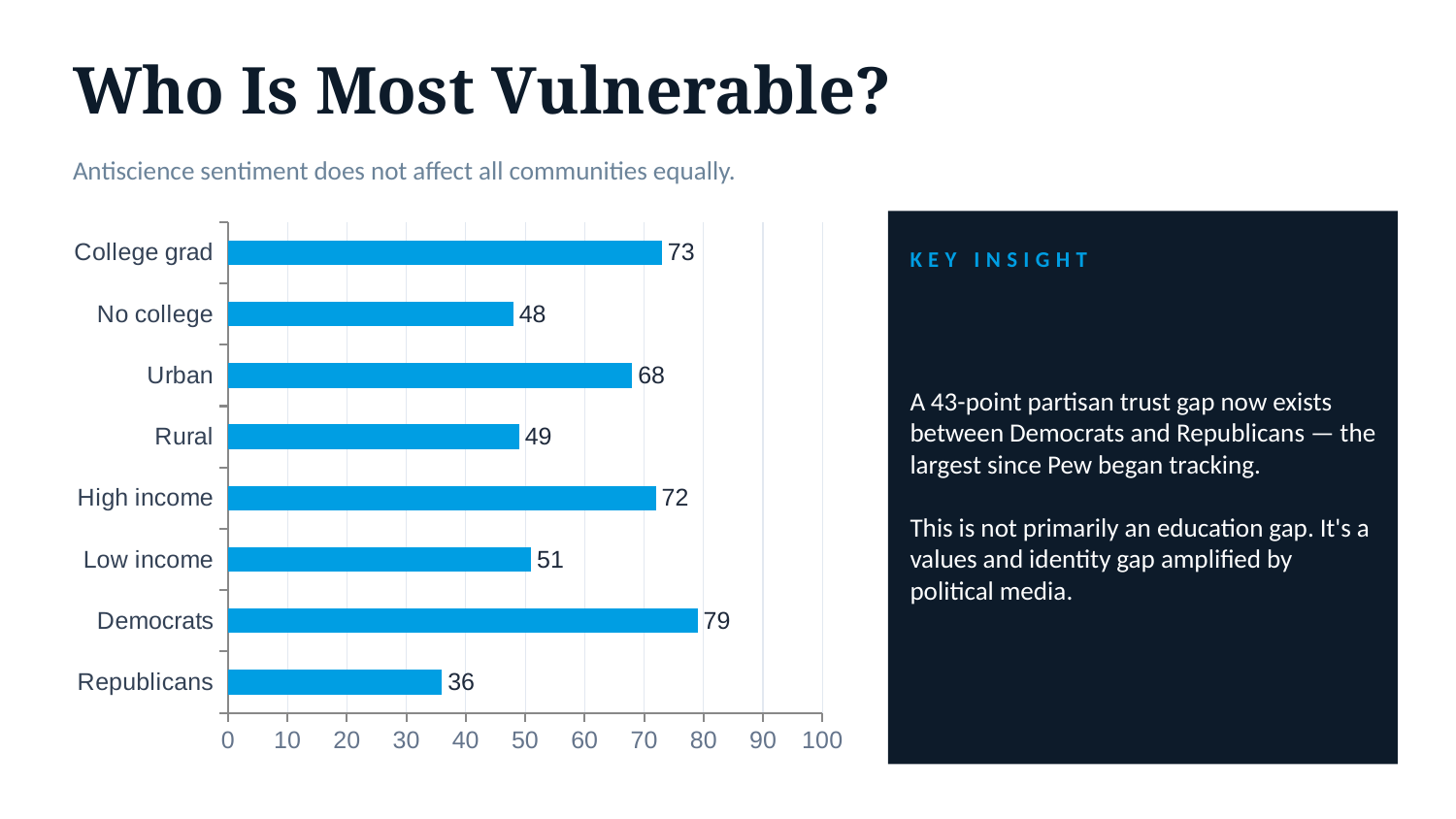
What is the difference between the values for College grad and No college? 25 Is the value for Rural greater or less than 60? less What is the value for Republicans? 36 What is the value for Urban? 68 Which category has the lowest value? Republicans How many categories are shown in the chart? 8 Which category has the highest value? Democrats What kind of chart is shown on the slide? bar chart What is the value for No college? 48 What is the value for Democrats? 79 What is the difference between the values for Democrats and Republicans? 43 Which is larger, the value for High income or the value for Low income? High income